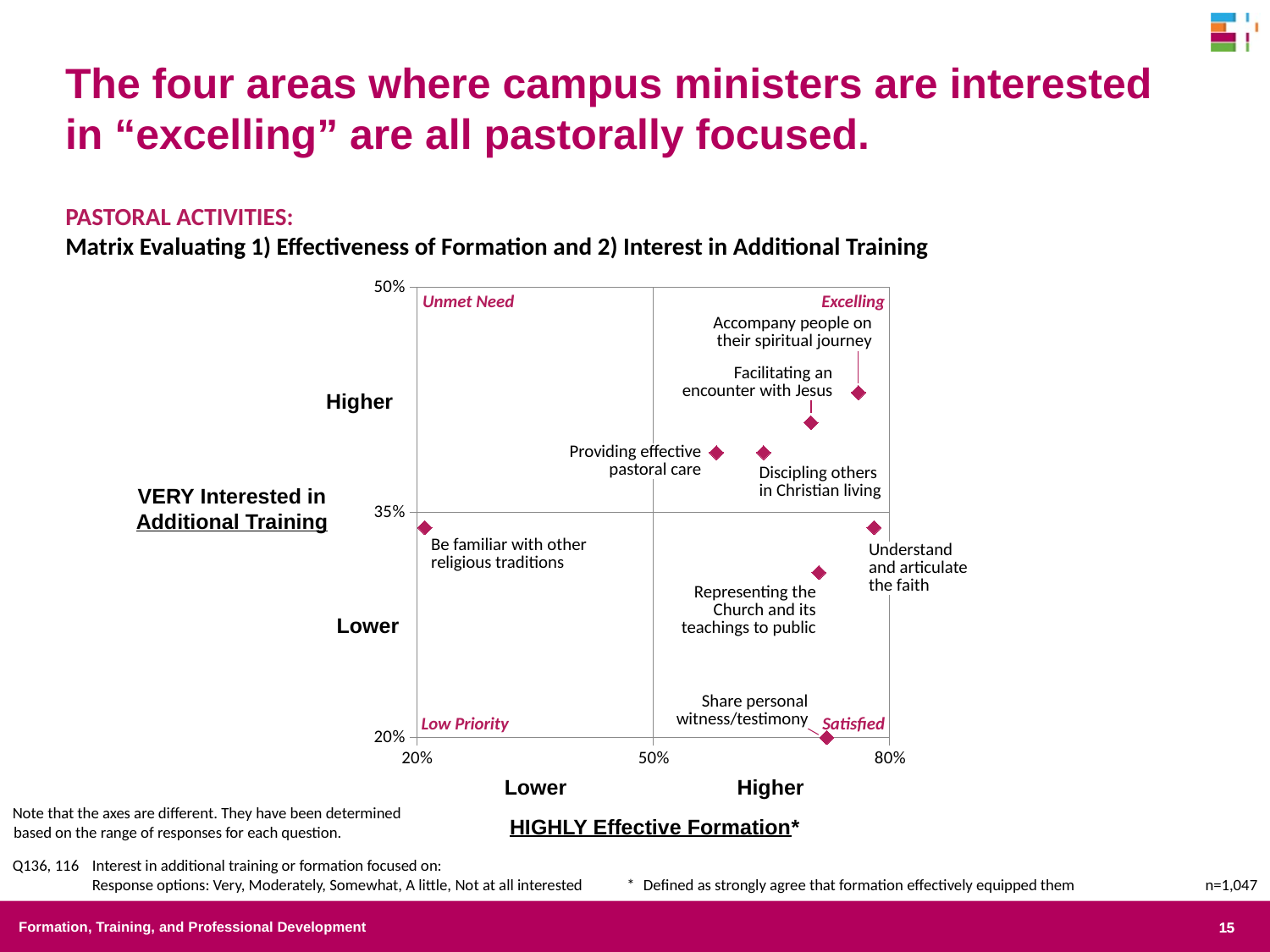
Is the VERY Interested in Additional Training value for 'Accompany people on their spiritual journey' greater or less than 35%? greater Is the HIGHLY Effective Formation value for 'Providing effective pastoral care' greater or less than 50%? greater Which pastoral activity has the highest value on the vertical axis (VERY Interested in Additional Training)? Accompany people on their spiritual journey Is the HIGHLY Effective Formation value for 'Be familiar with other religious traditions' greater or less than 50%? less Which has the higher VERY Interested in Additional Training value: 'Accompany people on their spiritual journey' or 'Representing the Church and its teachings to public'? Accompany people on their spiritual journey What is the label of the upper-right quadrant of the matrix? Excelling Which pastoral activity has the lowest value on the horizontal axis (HIGHLY Effective Formation)? Be familiar with other religious traditions What kind of chart is shown on the slide? scatter plot Which has the higher HIGHLY Effective Formation value: 'Be familiar with other religious traditions' or 'Understand and articulate the faith'? Understand and articulate the faith How many pastoral activities are plotted as points on the chart? 8 Which pastoral activity has the lowest value on the vertical axis (VERY Interested in Additional Training)? Share personal witness/testimony